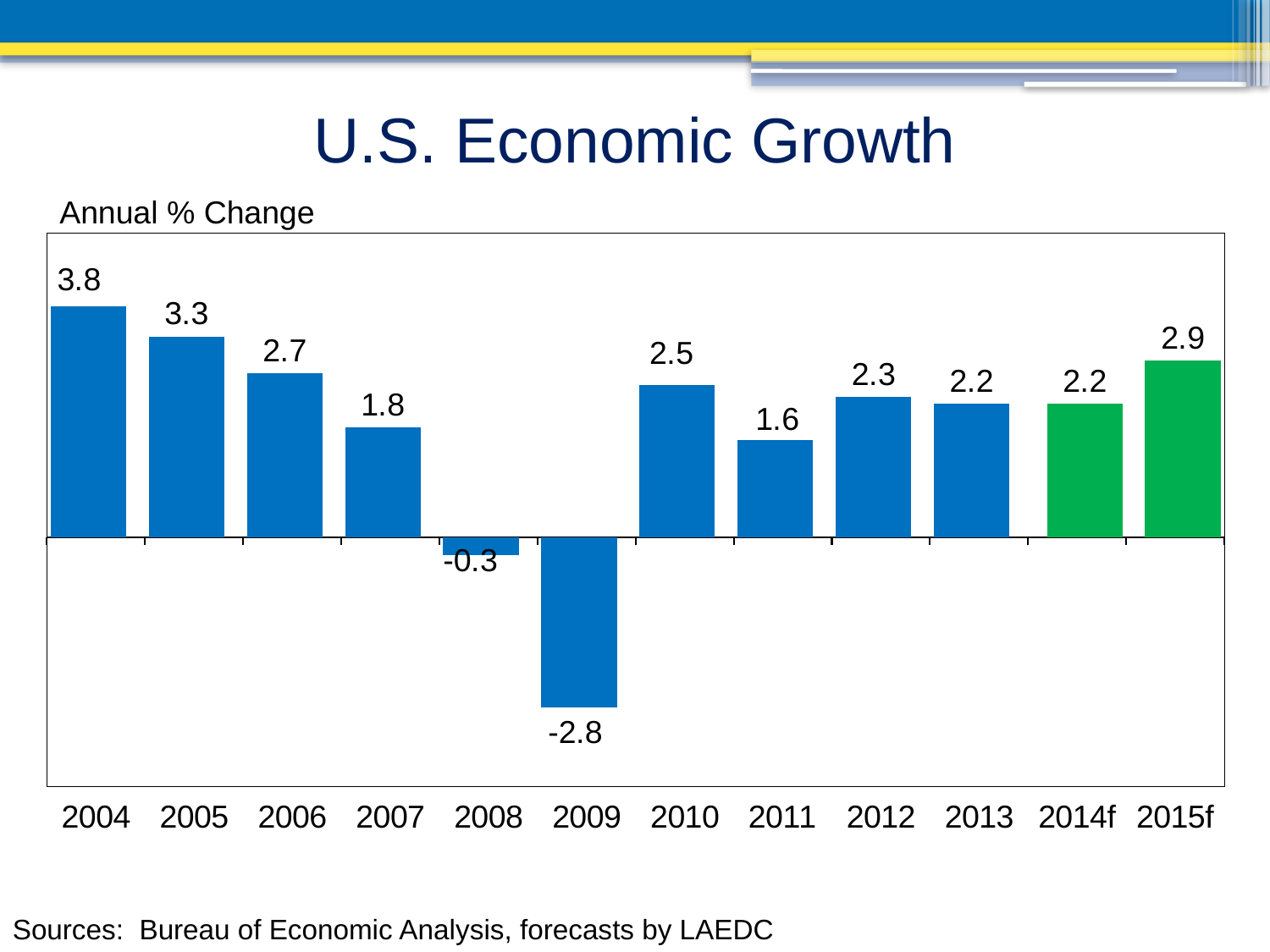
What is the difference between the values for 2004 and 2007? 2.0 What is the value shown for 2008? -0.3 Which year has the highest annual % change? 2004 Which year has the lowest annual % change? 2009 What kind of chart is shown on the slide? Bar chart How many years are shown on the x axis? 12 Which is larger, the value for 2010 or the value for 2011? 2010 What is the title of the chart? U.S. Economic Growth What is the value shown for 2009? -2.8 What is the annual % change in U.S. economic growth for 2004? 3.8 Do the values rise or fall from 2004 to 2007? Fall What is the forecast value for 2015f? 2.9